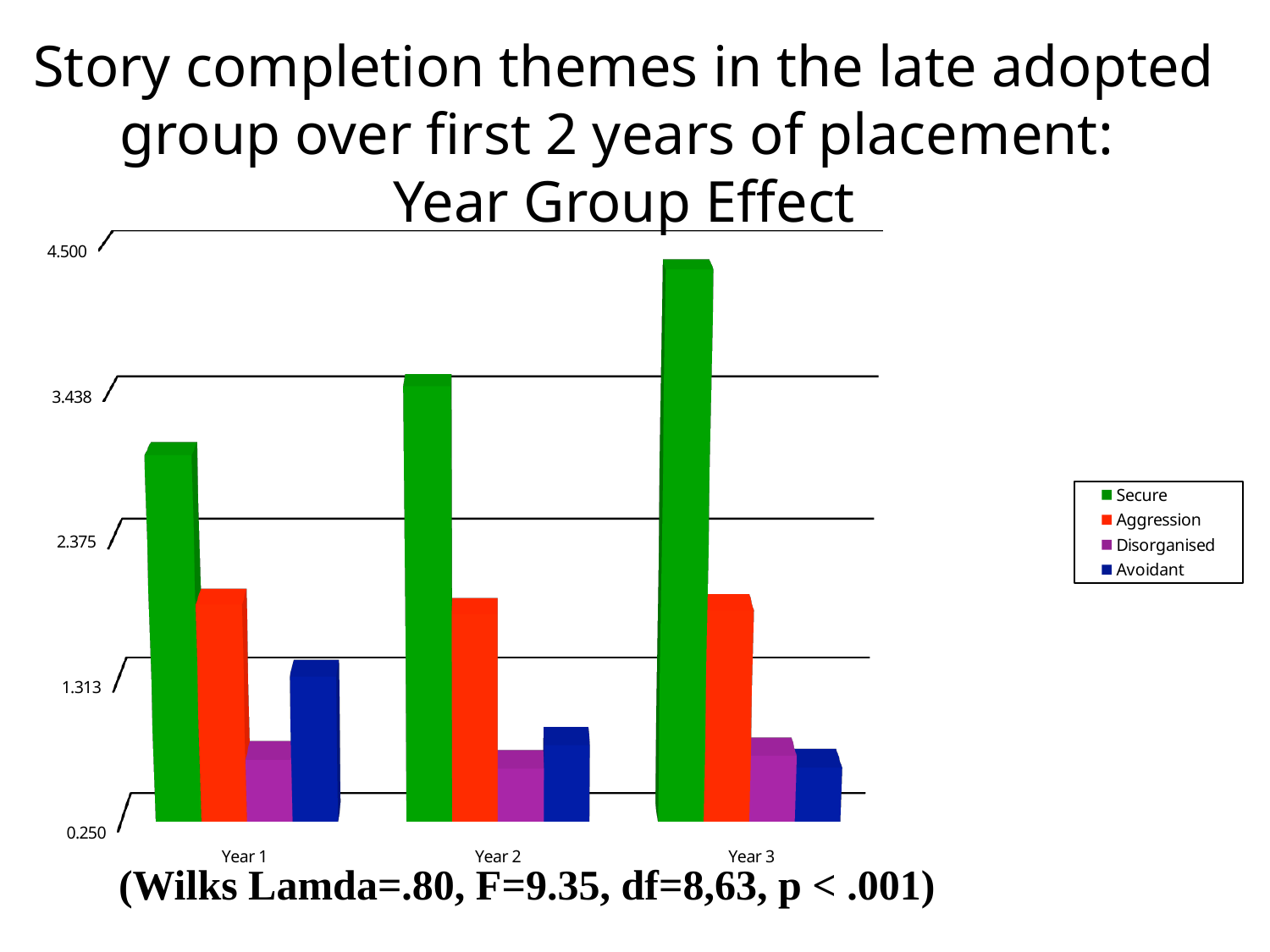
Which series has the lowest value in Year 1? Disorganised In which year is the Secure value highest? Year 3 Does the Secure value rise or fall from Year 1 to Year 3? rise Is the Secure value for Year 1 greater or less than 3.438? less How many series does the legend list? 4 Which series has the highest value in Year 3? Secure What kind of chart is shown on the slide? bar chart Which colour represents the Aggression series in the legend? red Is the Secure value for Year 3 greater or less than 3.438? greater Is the Aggression value for Year 1 greater or less than 2.375? less How many year groups are shown on the x axis? 3 In which year is the Avoidant value highest? Year 1